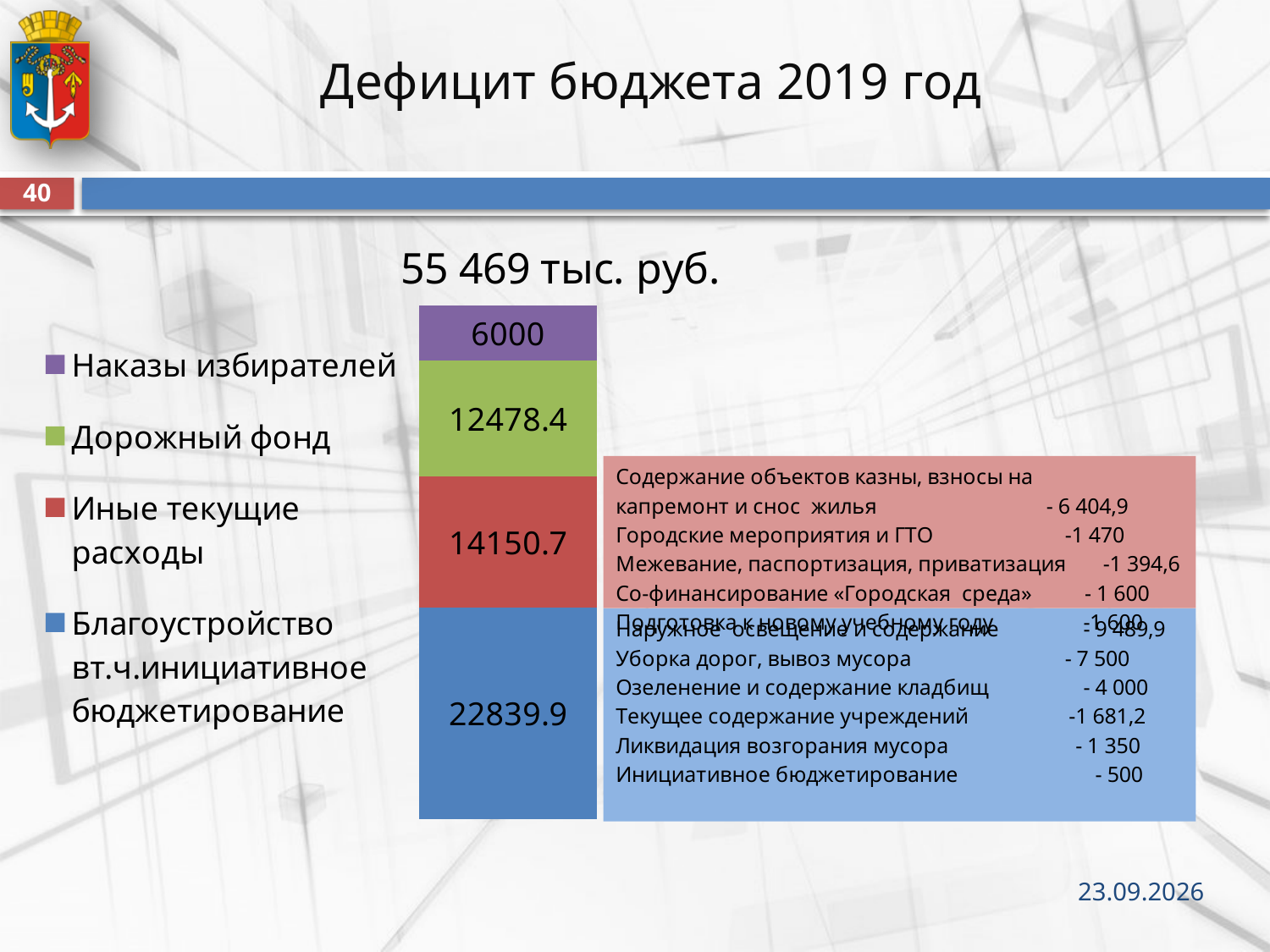
What is the value for Дорожный фонд? 12478.4 What is the difference between the values for Иные текущие расходы and Дорожный фонд? 1672.3 How many series does the legend list? 4 What kind of chart is shown on the slide? Stacked bar chart What is the value for Благоустройство вт.ч.инициативное бюджетирование? 22839.9 Which segment of the stacked bar has the largest value? Благоустройство вт.ч.инициативное бюджетирование Which is larger: Дорожный фонд or Наказы избирателей? Дорожный фонд Which segment of the stacked bar has the smallest value? Наказы избирателей What is the value for Наказы избирателей? 6000 What is the value for Иные текущие расходы? 14150.7 What is the total of the stacked bar? 55469 What is the title of the slide containing the chart? Дефицит бюджета 2019 год